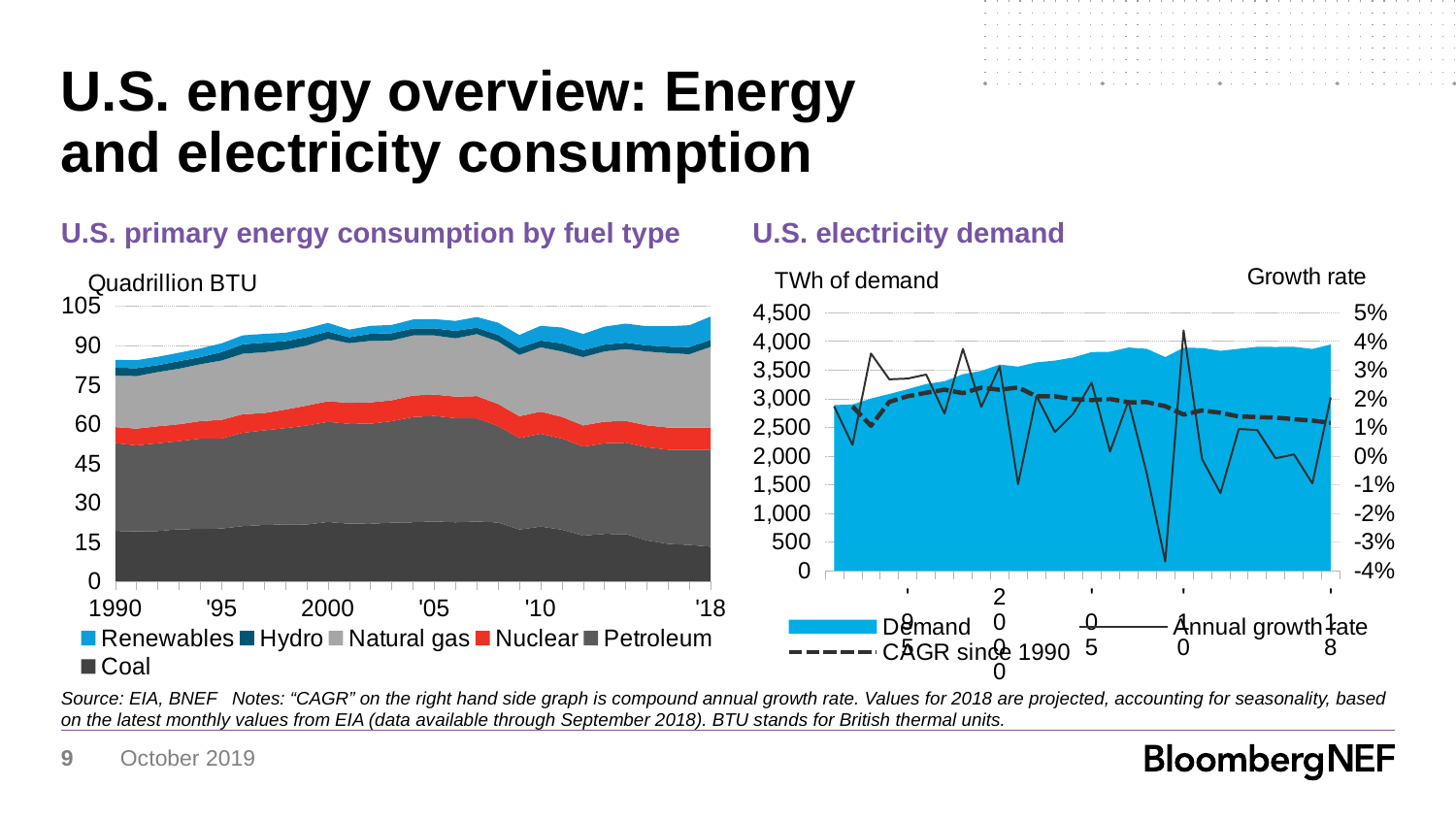
How many series does the legend of the 'U.S. primary energy consumption by fuel type' chart list? 6 In the 'U.S. primary energy consumption by fuel type' chart, is the value for Coal in 1990 greater or less than 30? less In the 'U.S. electricity demand' chart, is the Demand value in 1990 greater or less than 3,000? less In the 'U.S. electricity demand' chart, does Demand generally rise or fall from 1990 to 2018? rise How many series does the legend of the 'U.S. electricity demand' chart list? 3 What kind of chart is the 'U.S. primary energy consumption by fuel type' chart? Stacked area chart In the 'U.S. electricity demand' chart, is the Demand value in 2018 greater or less than 3,500? greater What unit is shown on the y axis of the 'U.S. primary energy consumption by fuel type' chart? Quadrillion BTU In the 'U.S. primary energy consumption by fuel type' chart, does the Coal series rise or fall between 2010 and 2018? fall What label is shown on the right-hand axis of the 'U.S. electricity demand' chart? Growth rate